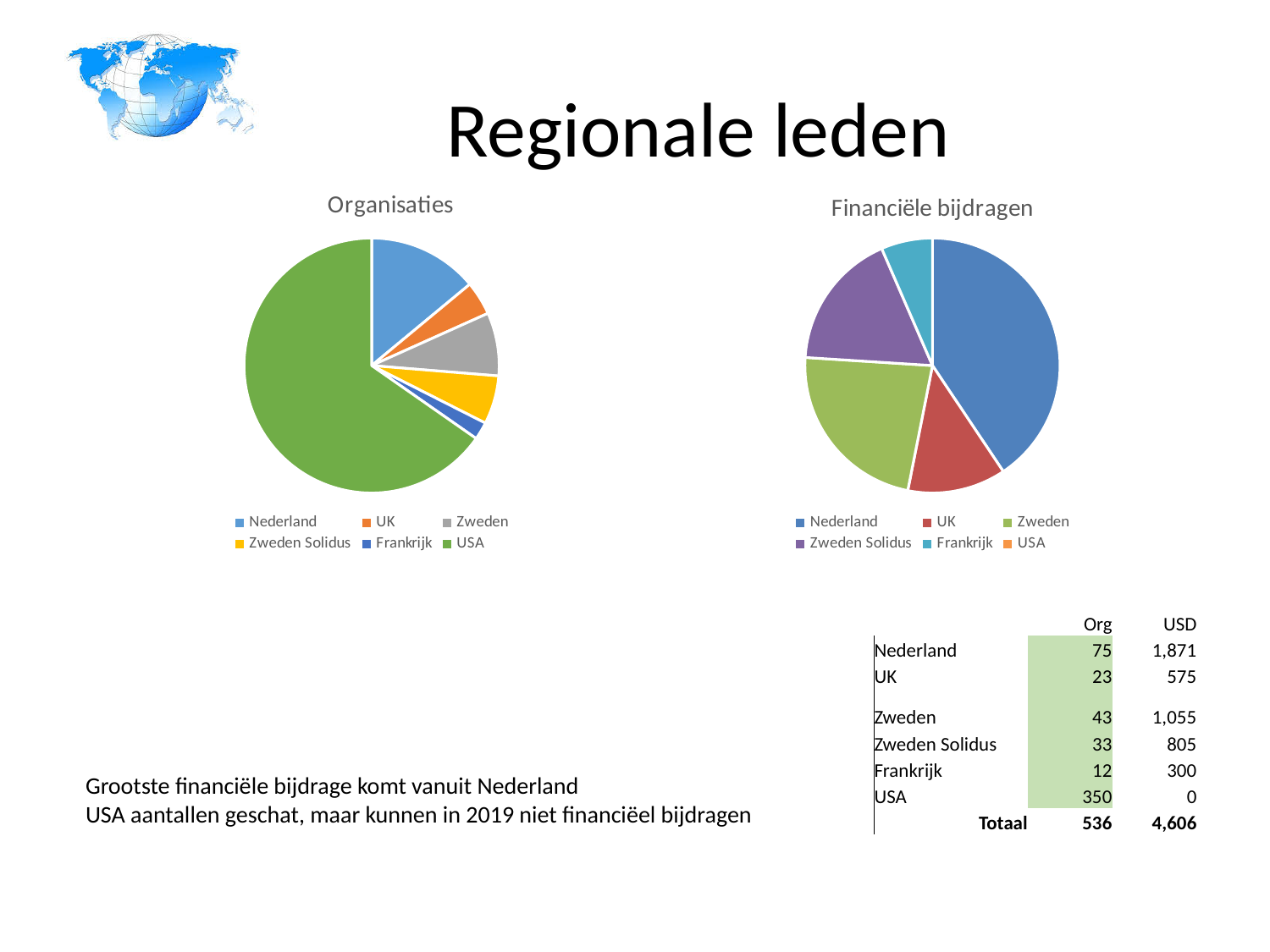
How many categories does the legend of the "Financiële bijdragen" chart list? 6 What kind of chart is the "Organisaties" chart? pie chart According to the table, how many organisations (Org) does Zweden have in the "Organisaties" chart? 43 What is the total (Totaal) of the USD column in the table? 4,606 What is the difference in USD between Nederland and UK in the table? 1,296 In the "Organisaties" chart, what colour is the USA slice? green In the "Organisaties" chart, which category has the largest slice? USA In the "Financiële bijdragen" chart, which category has the largest slice? Nederland According to the table, what is the USD value for Nederland shown in the "Financiële bijdragen" chart? 1,871 In the "Organisaties" chart, which category has the smallest slice? Frankrijk What is the total (Totaal) of the Org column in the table? 536 In the "Organisaties" chart, which slice is larger: Zweden or Zweden Solidus? Zweden